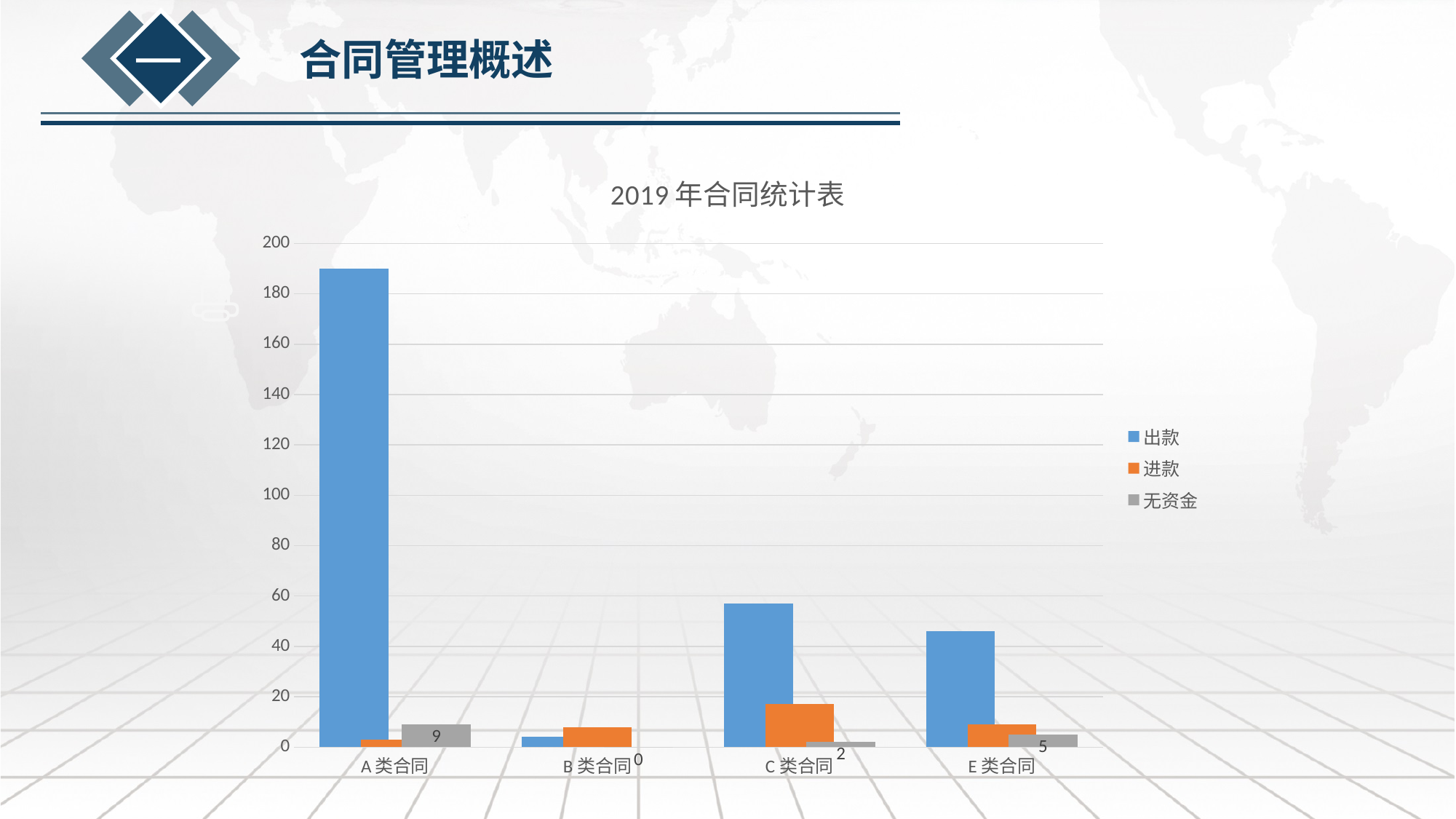
Which category has the highest 出款 value? A 类合同 How many contract categories are shown on the x axis? 4 How many series does the legend list? 3 Is the 出款 value for A 类合同 greater or less than 180? greater What is the title of the chart? 2019 年合同统计表 Which category has the highest 无资金 value? A 类合同 What is the 无资金 value for E 类合同? 5 What is the 无资金 value for B 类合同? 0 What is the 无资金 value for A 类合同? 9 What is the 无资金 value for C 类合同? 2 What kind of chart is shown on the slide? bar chart What is the difference between the 无资金 values for A 类合同 and E 类合同? 4